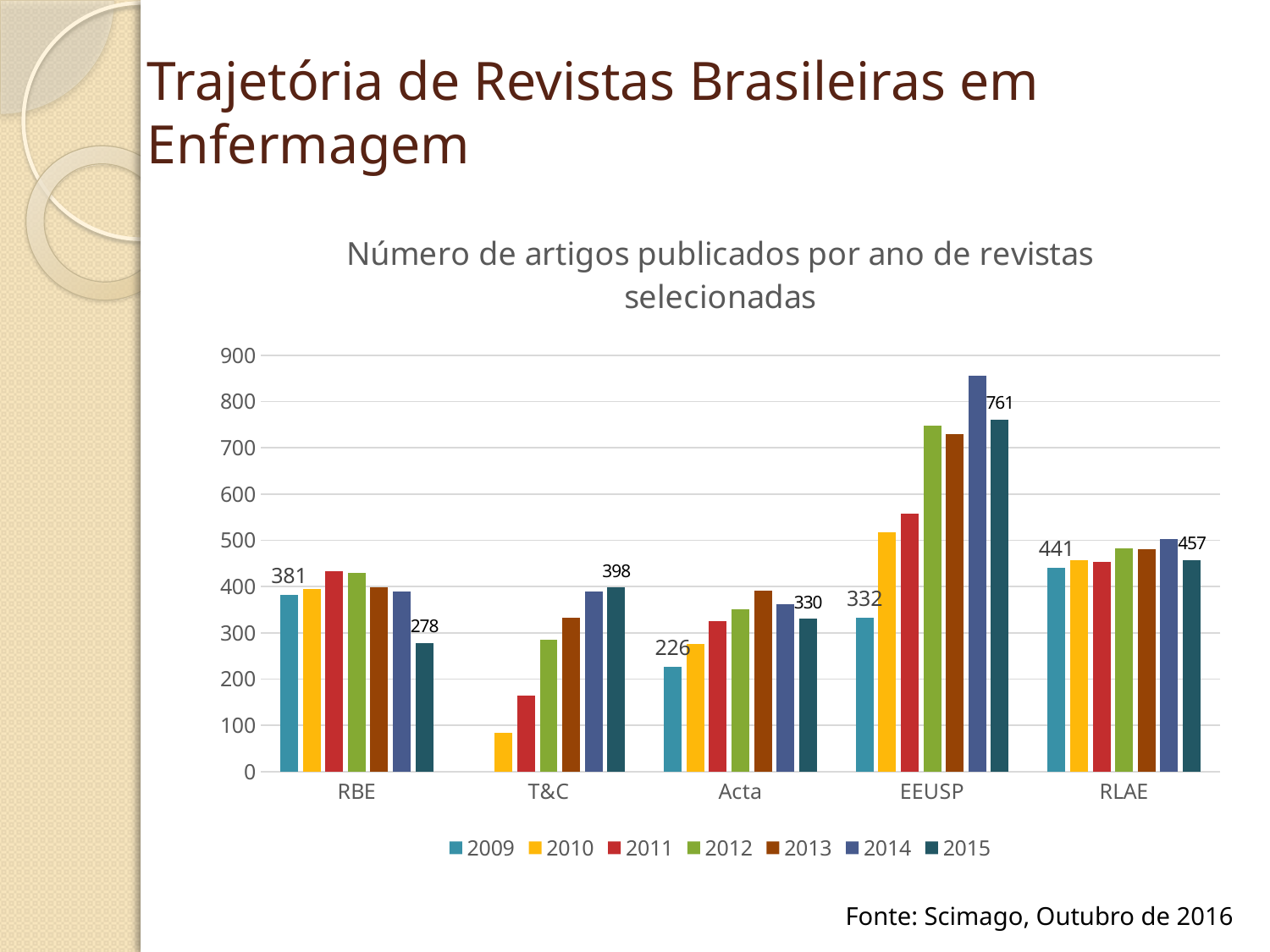
What is the difference between the 2015 and 2009 values for RLAE? 16 What is the value for T&C in 2015? 398 How many series does the legend list? 7 What is the value for Acta in 2009? 226 Which is larger in 2015, Acta or RBE? Acta What is the value for EEUSP in 2015? 761 How many journals are shown on the x axis? 5 By how much did RBE's value fall from 2009 to 2015? 103 Which journal has the highest value in 2015? EEUSP How many articles did RBE publish in 2009? 381 What is the difference between EEUSP's 2015 and 2009 values? 429 Is the value for EEUSP in 2014 greater or less than 800? greater